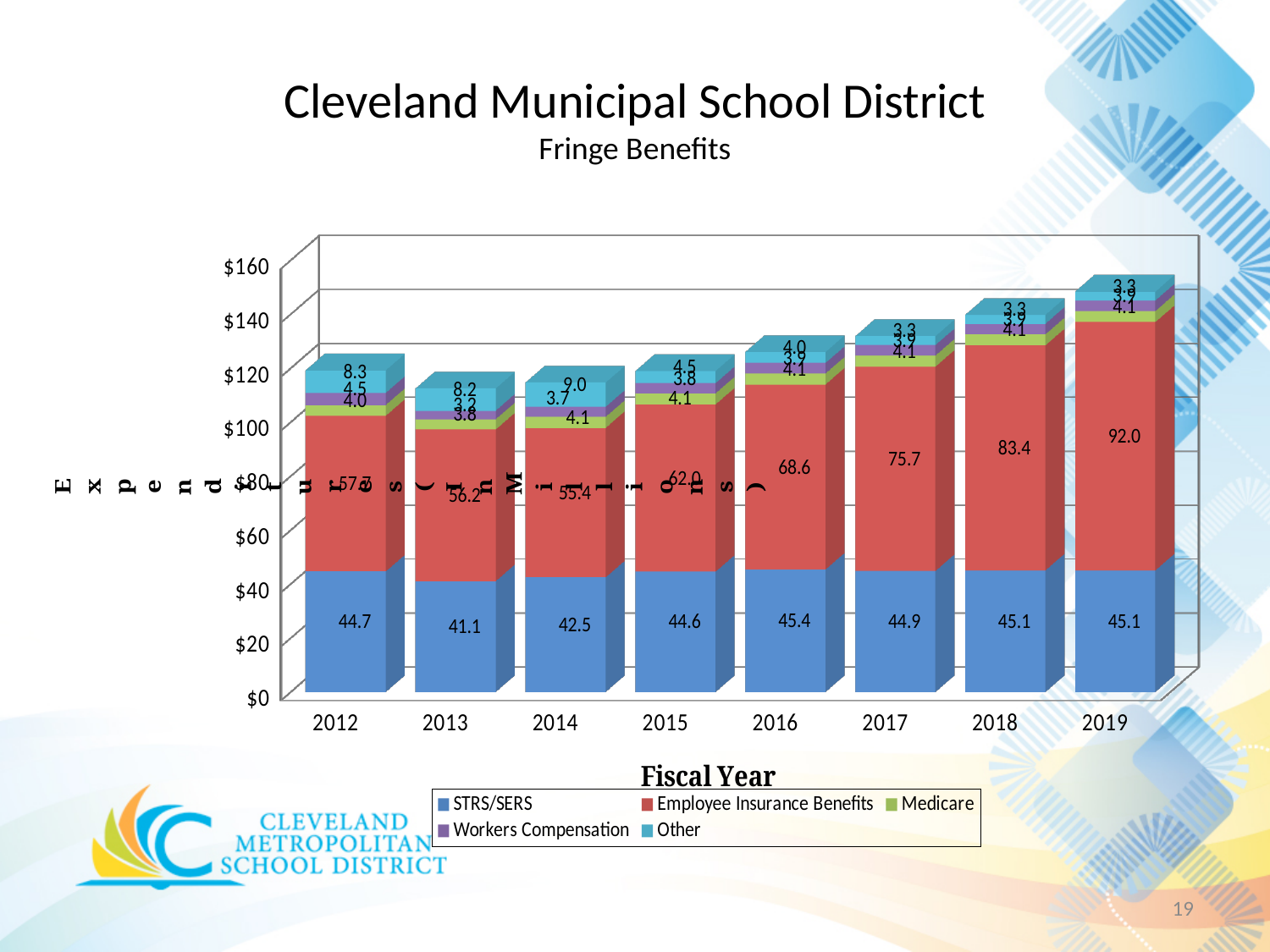
Which fiscal year has the larger STRS/SERS value, 2016 or 2017? 2016 In which fiscal year is the STRS/SERS value the lowest? 2013 Is the total height of the 2019 stacked bar greater or less than $140? greater What is the STRS/SERS value for fiscal year 2013? 41.1 Do the Employee Insurance Benefits values rise or fall from 2014 to 2019? rise In which fiscal year is the Employee Insurance Benefits value the highest? 2019 How many fiscal years are shown on the x axis? 8 What is the difference between the Employee Insurance Benefits values for 2017 and 2016? 7.1 How many series does the legend list? 5 What is the value of Employee Insurance Benefits for fiscal year 2019? 92.0 What is the difference between the Employee Insurance Benefits values for 2019 and 2018? 8.6 What is the value of the Other segment for fiscal year 2014? 9.0